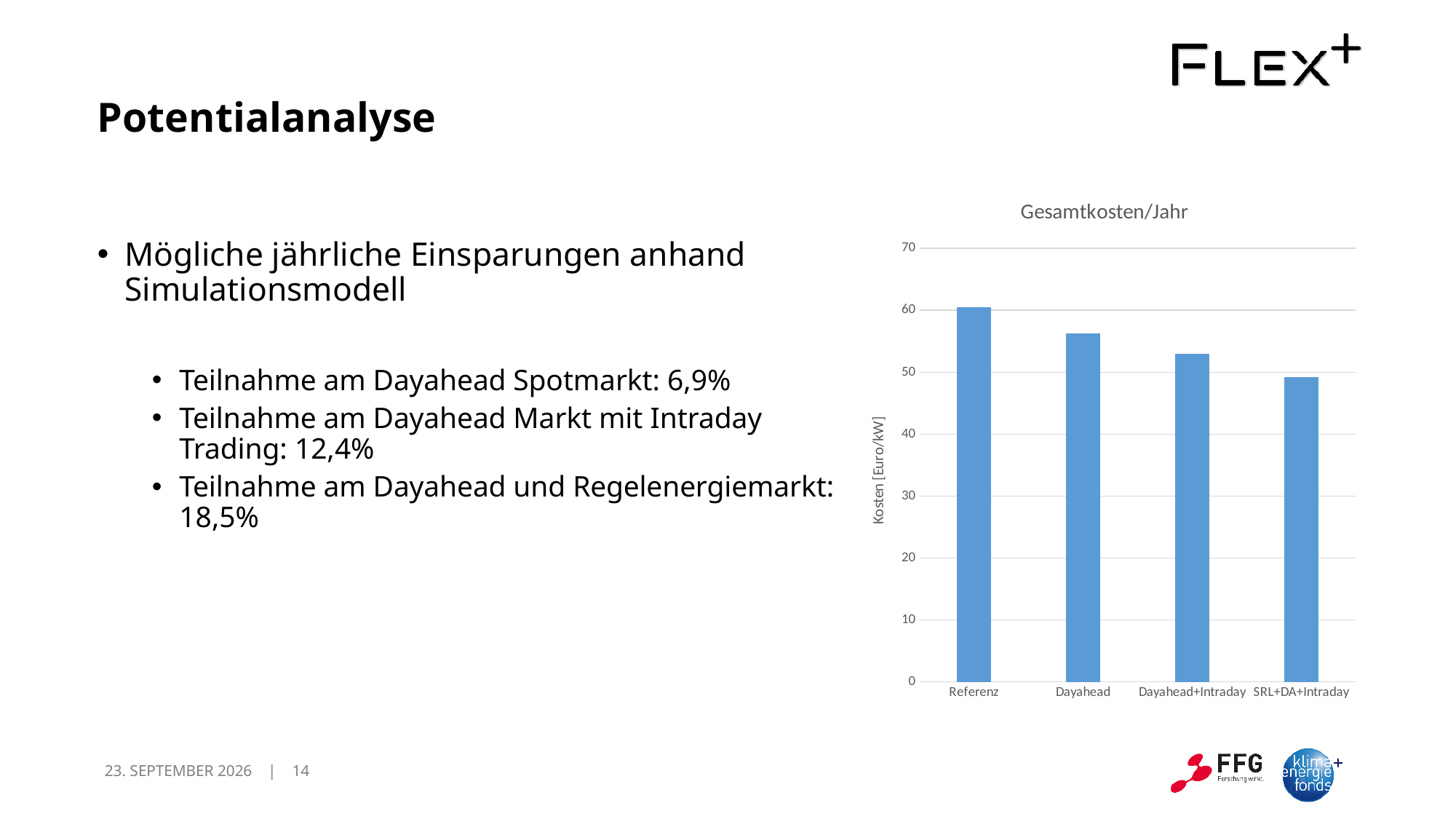
What is the label of the vertical axis of the chart? Kosten [Euro/kW] Is the value for Dayahead greater or less than 60? less What type of chart is shown on the slide? bar chart Is the value for Dayahead+Intraday greater or less than 50? greater Which is larger, the value for Dayahead+Intraday or the value for SRL+DA+Intraday? Dayahead+Intraday What is the title of the chart? Gesamtkosten/Jahr How many categories are shown on the x axis of the chart? 4 Is the value for SRL+DA+Intraday greater or less than 40? greater Which category has the highest value in the chart? Referenz Which is larger, the value for Referenz or the value for Dayahead? Referenz Do the values rise or fall from left to right along the x axis? fall Which category has the lowest value in the chart? SRL+DA+Intraday